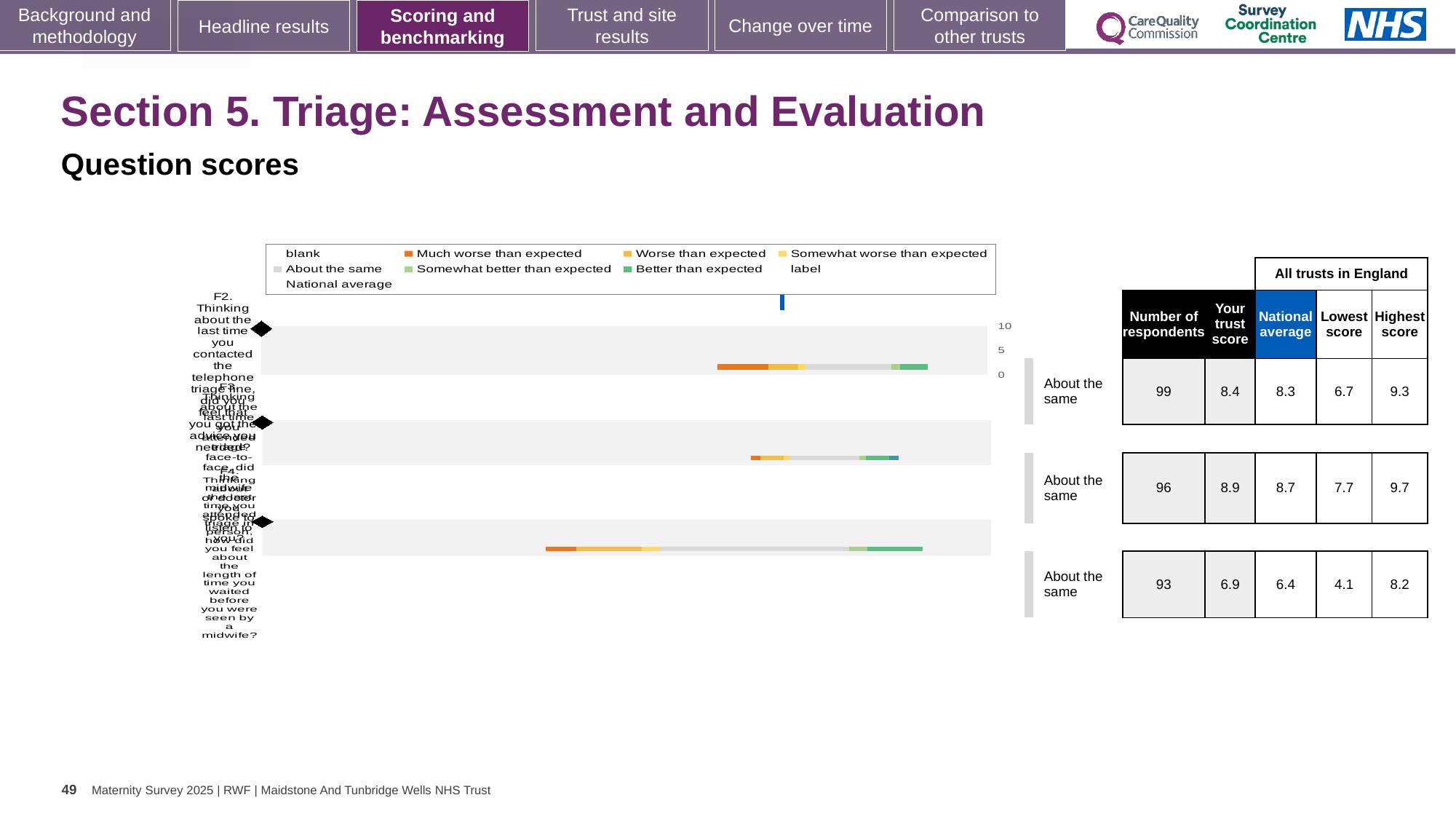
What kind of chart is shown on the slide? bar chart Which question (F2, F3 or F4) has the lowest trust score in the table beside the chart? F4 What benchmark category is shown next to the bar for question F4? About the same In the chart legend, what colour represents 'Much worse than expected'? orange Which question (F2, F3 or F4) has the highest trust score in the table beside the chart? F3 According to the table beside the chart, how many respondents answered question F2? 99 In the chart legend, what colour represents 'Better than expected'? green How many question rows (bars) are plotted in the chart? 3 By how much does the trust score for F3 exceed the national average for F3? 0.2 According to the table beside the chart, what is the national average for question F4? 6.4 For question F2, which is larger: the trust score or the national average? trust score According to the table beside the chart, what is the trust score for question F3? 8.9